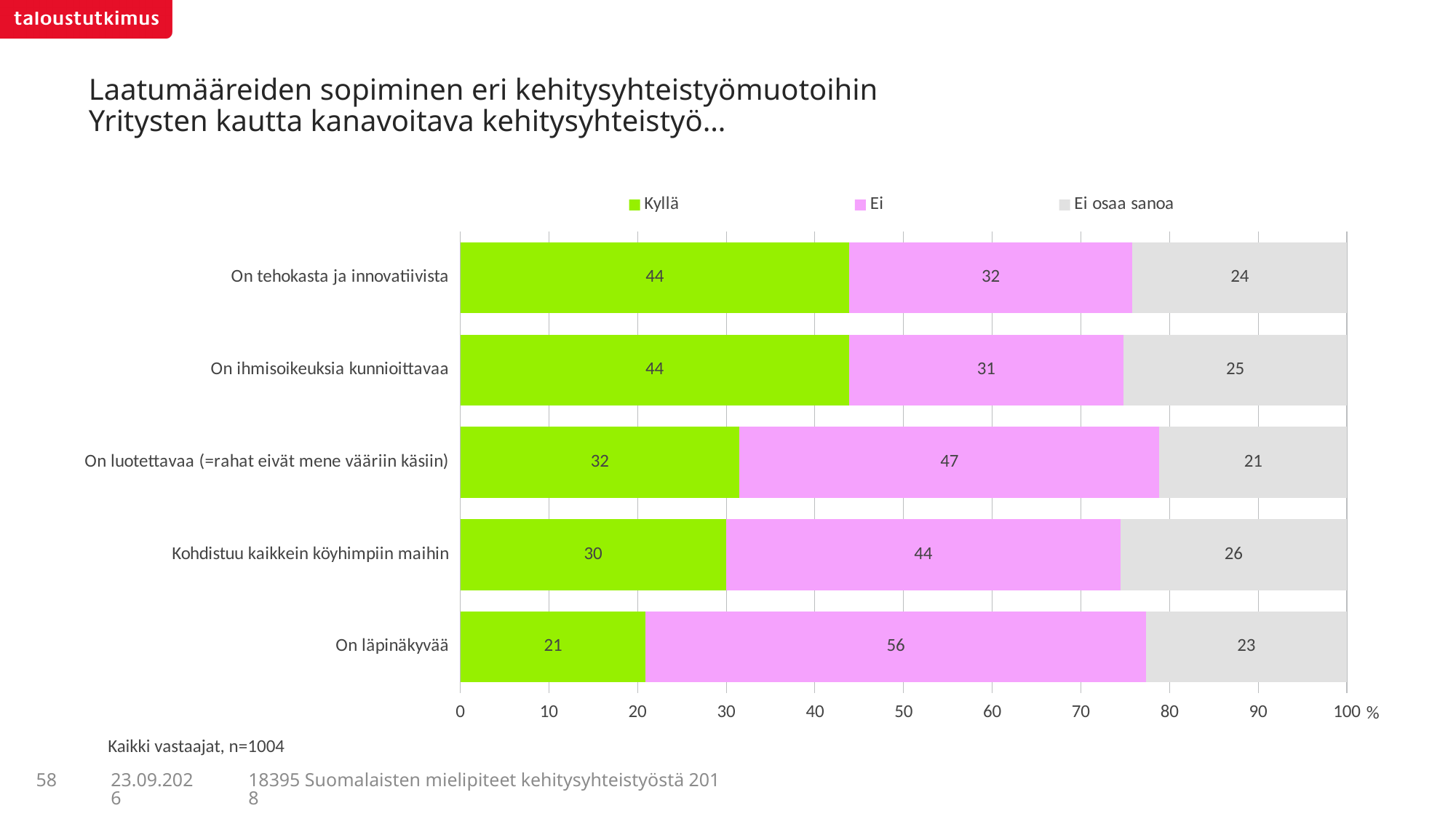
What is the "Ei osaa sanoa" value for "Kohdistuu kaikkein köyhimpiin maihin"? 26 What is the total of the stacked bar for "On ihmisoikeuksia kunnioittavaa"? 100 What kind of chart is shown on the slide? Stacked bar chart Which category has the highest "Ei" value? On läpinäkyvää Which is larger for "On tehokasta ja innovatiivista": the "Kyllä" value or the "Ei" value? Kyllä Which category has the lowest "Kyllä" value? On läpinäkyvää What is the difference between the "Ei" value and the "Kyllä" value for "On läpinäkyvää"? 35 How many series does the legend list? 3 Which colour represents the "Ei osaa sanoa" series? Grey How many categories are shown on the chart? 5 What is the "Ei" value for "On luotettavaa (=rahat eivät mene vääriin käsiin)"? 47 What is the "Kyllä" value for "On läpinäkyvää"? 21